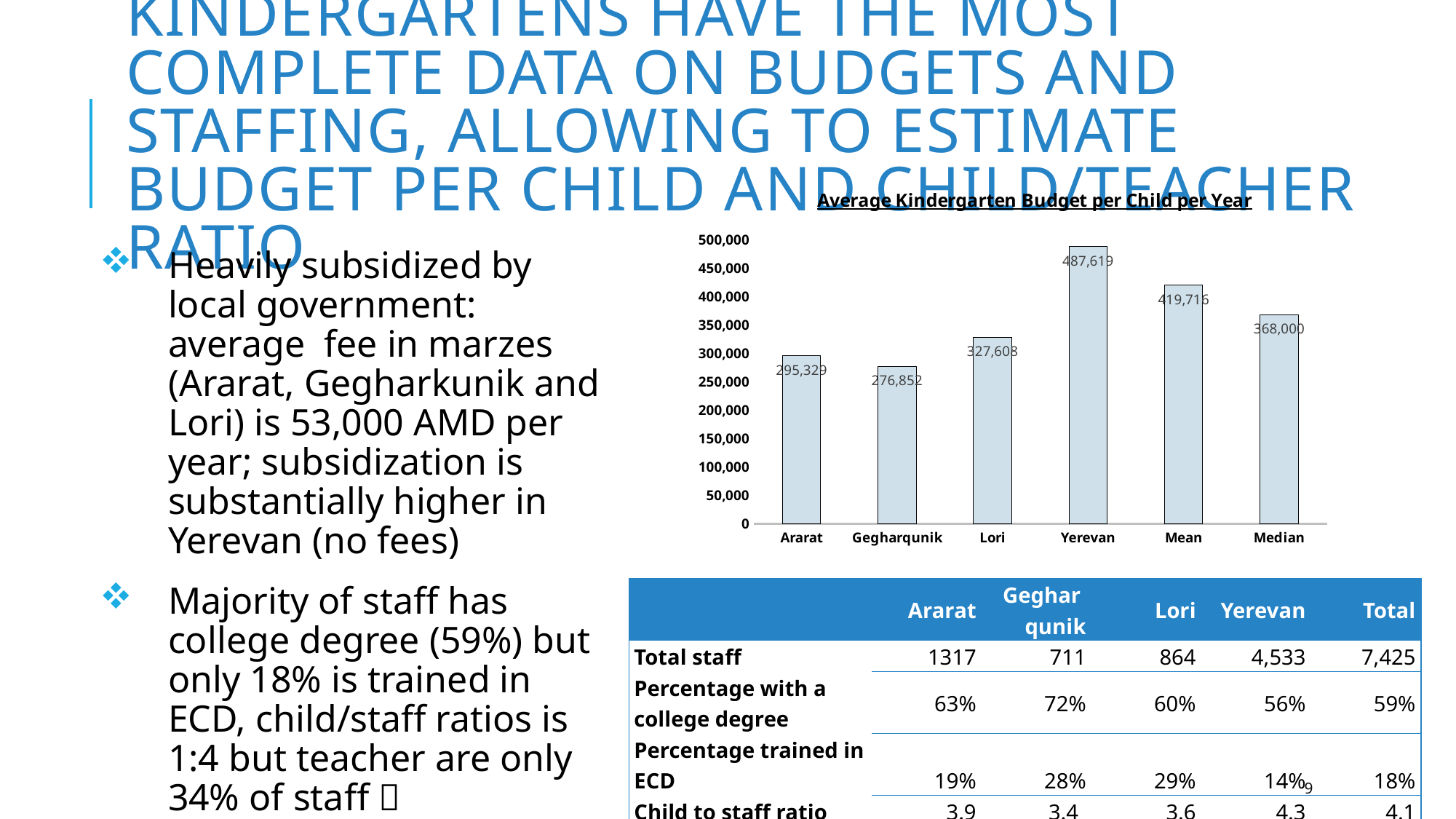
What is the title of the chart? Average Kindergarten Budget per Child per Year Which category has the lowest average kindergarten budget per child per year? Gegharqunik What is the Median value shown in the chart? 368,000 Which category has the highest average kindergarten budget per child per year? Yerevan What is the average kindergarten budget per child per year for Yerevan? 487,619 Which is larger in the chart, the Mean or the Median? Mean What is the average kindergarten budget per child per year for Ararat? 295,329 How many bars are shown in the chart? 6 What is the average kindergarten budget per child per year for Lori? 327,608 What type of chart is shown on the slide? bar chart What is the difference between the Yerevan value and the Ararat value in the chart? 192,290 What is the average kindergarten budget per child per year for Gegharqunik? 276,852